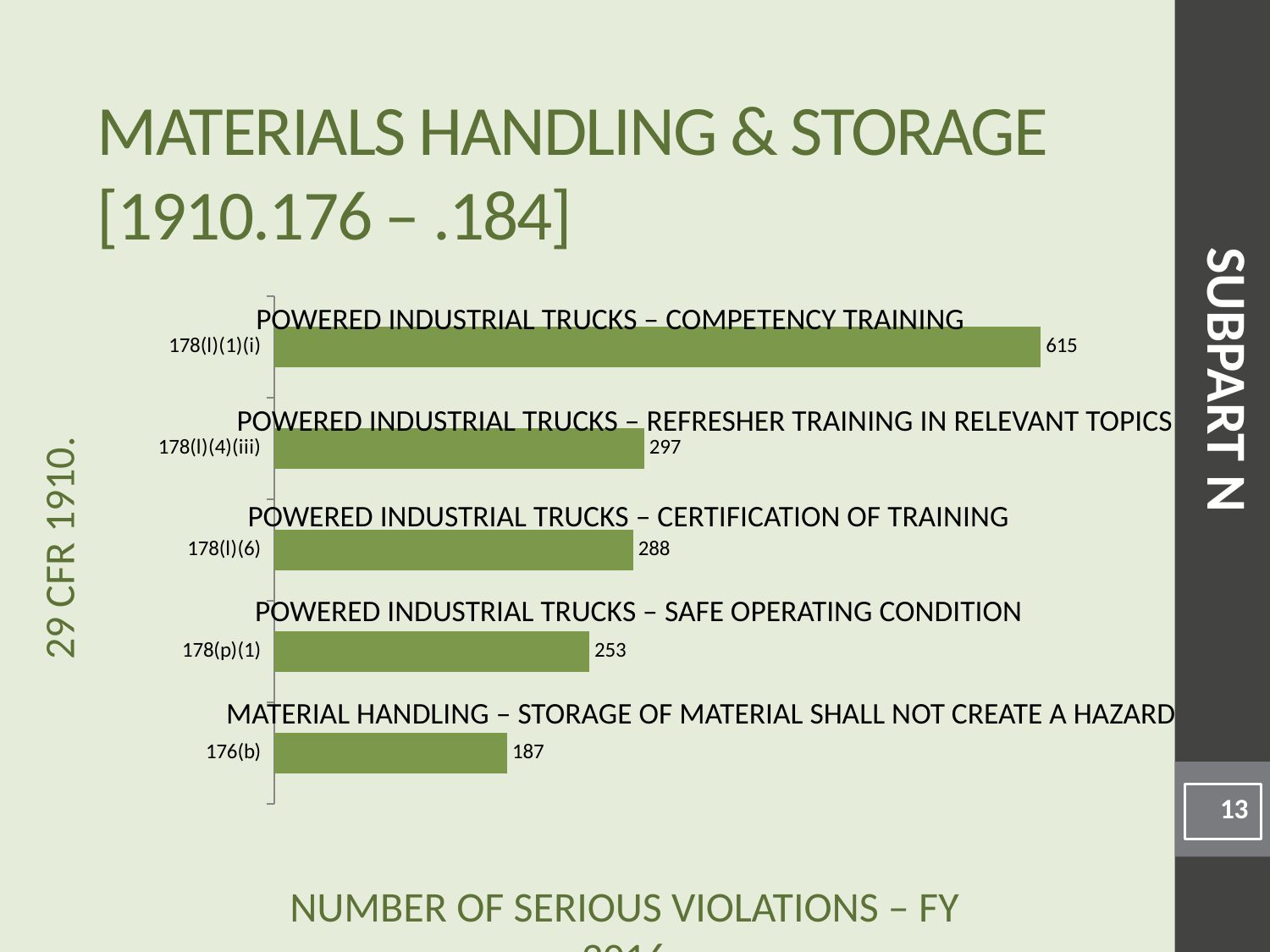
How many categories are shown in the chart? 5 Which category has the lowest number of serious violations? 176(b) What is the value shown for 178(p)(1)? 253 Which standard corresponds to the bar labelled 'POWERED INDUSTRIAL TRUCKS – CERTIFICATION OF TRAINING'? 178(l)(6) What kind of chart is shown on the slide? Bar chart Which category has the highest number of serious violations? 178(l)(1)(i) What is the number of serious violations for 176(b)? 187 What is the difference between the values for 178(l)(6) and 176(b)? 101 What is the number of serious violations for 178(l)(4)(iii)? 297 What is the difference between the values for 178(l)(1)(i) and 178(l)(4)(iii)? 318 What is the number of serious violations for 178(l)(1)(i)? 615 Which has a larger value, 178(l)(6) or 178(p)(1)? 178(l)(6)